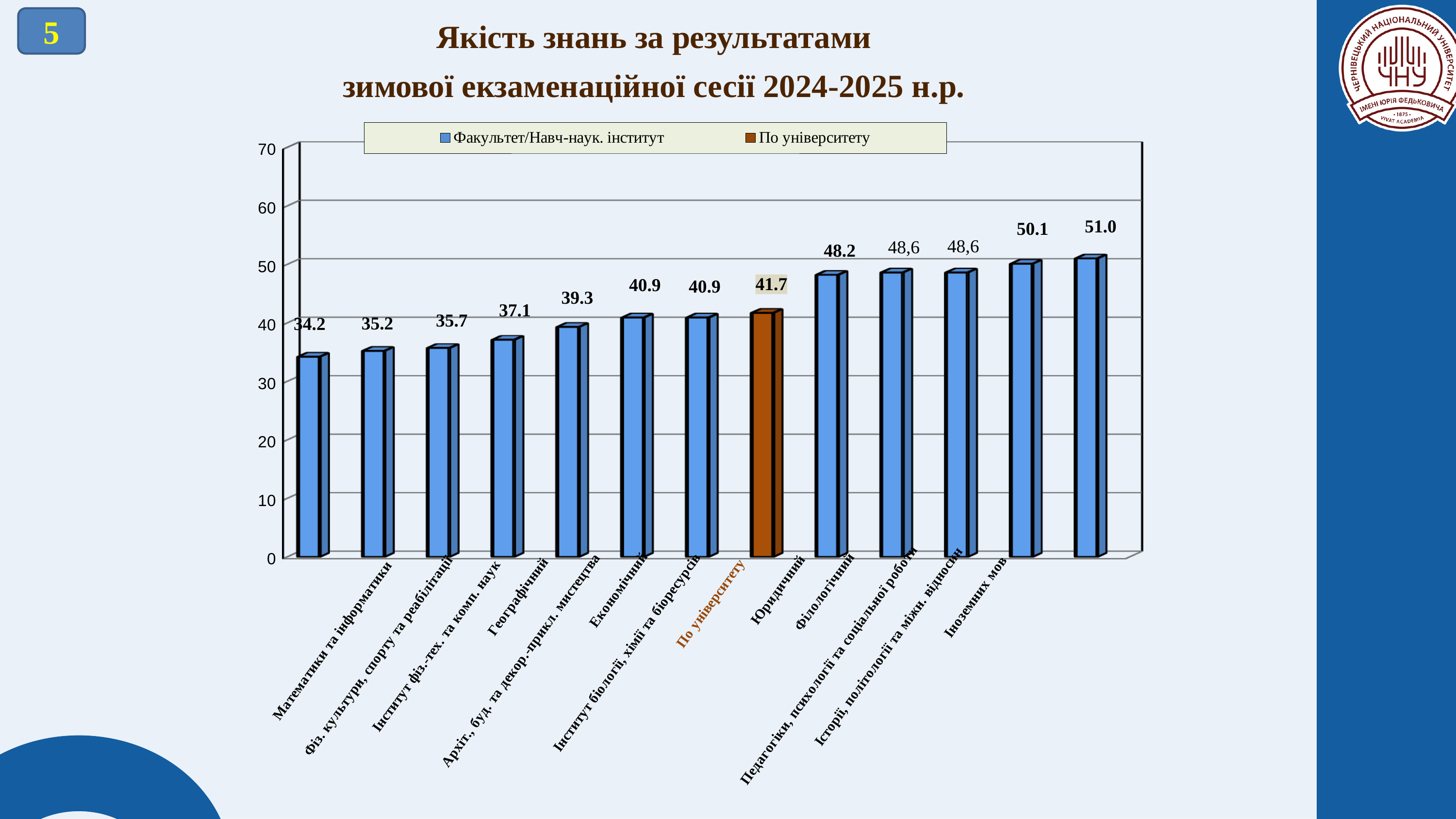
How many series does the legend list? 2 What is the value for Географічний? 37.1 Which category has the lowest value? Математики та інформатики Which category has the highest value? Іноземних мов What is the value for Філологічний? 48,6 Which is larger, the value for Юридичний or the value for Економічний? Юридичний Is the value for Історії, політології та міжн. відносин greater or less than 40? greater What is the value for Математики та інформатики? 34.2 How many bars are plotted in the chart? 13 What is the value for По університету? 41.7 What kind of chart is shown on the slide? bar chart What is the difference between the values for Іноземних мов and Математики та інформатики? 16.8